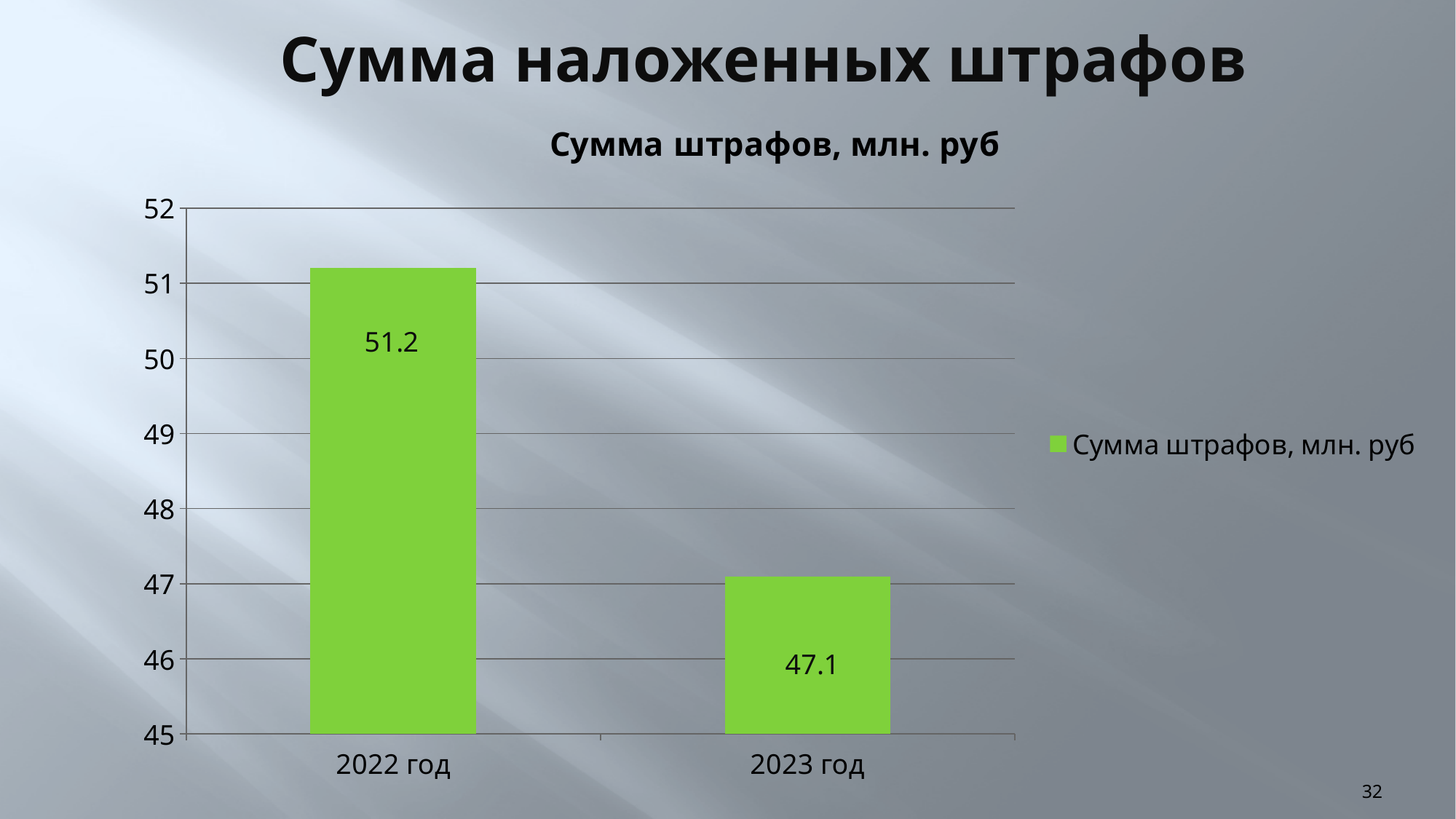
How many categories are shown on the x axis? 2 What kind of chart is shown? bar chart Which is larger, the value for 2022 год or the value for 2023 год? 2022 год What is the value for 2023 год? 47.1 Is the value for 2022 год greater or less than 50? greater How many series does the legend list? 1 Which year has the lowest value? 2023 год Do the values rise or fall from 2022 год to 2023 год? fall Which year has the highest value? 2022 год Is the value for 2023 год greater or less than 48? less What is the value for 2022 год? 51.2 What is the difference between the values for 2022 год and 2023 год? 4.1